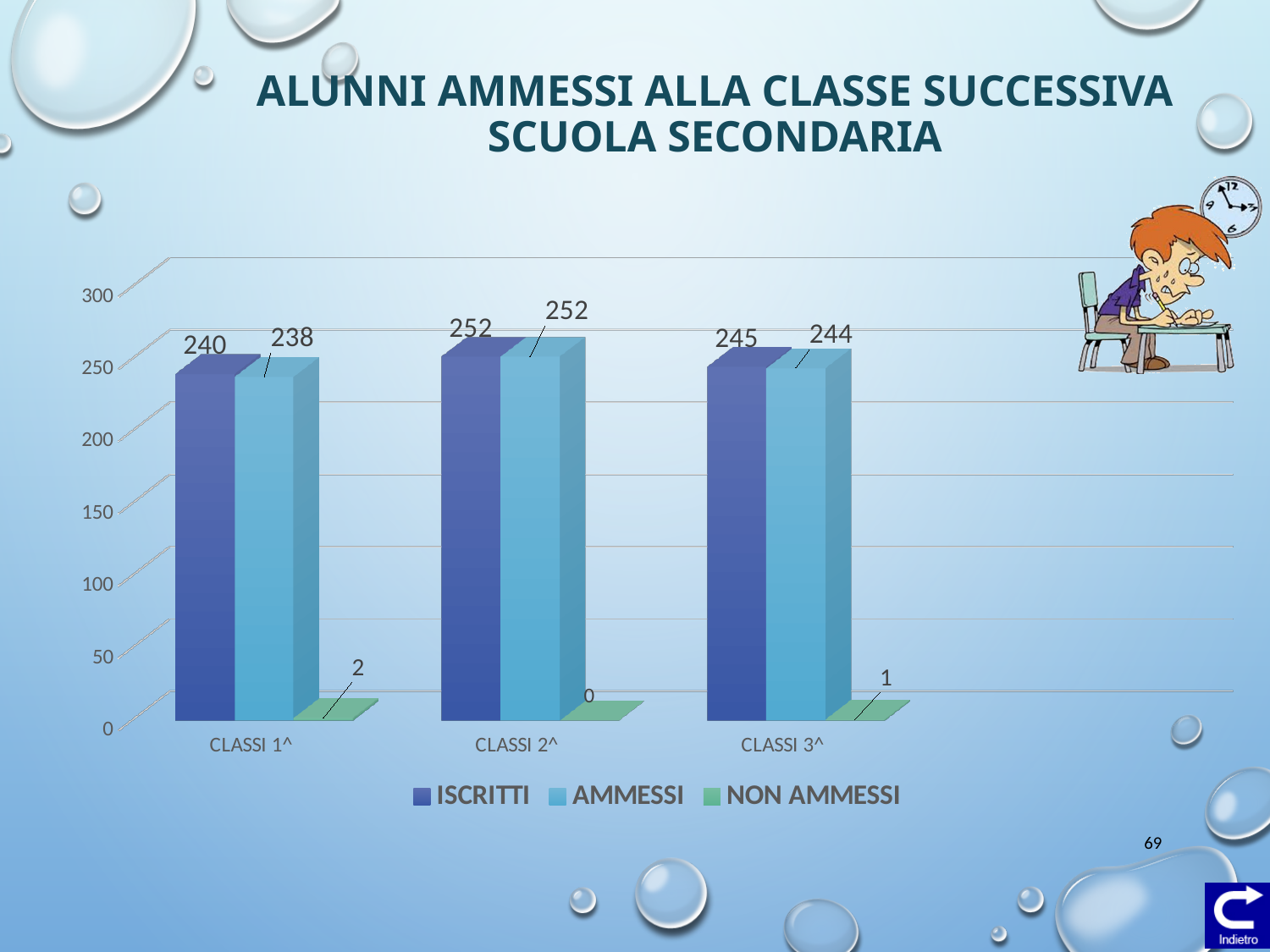
What is the NON AMMESSI value for CLASSI 3^? 1 How many classes are shown on the x axis? 3 What is the difference between the ISCRITTI values for CLASSI 2^ and CLASSI 3^? 7 Which is larger, the AMMESSI value for CLASSI 3^ or the AMMESSI value for CLASSI 1^? CLASSI 3^ What is the difference between ISCRITTI and AMMESSI for CLASSI 1^? 2 What kind of chart is shown on the slide? bar chart What is the title of the chart? ALUNNI AMMESSI ALLA CLASSE SUCCESSIVA SCUOLA SECONDARIA Which class has the lowest AMMESSI value? CLASSI 1^ How many series does the legend list? 3 What is the ISCRITTI value for CLASSI 1^? 240 Which class has the highest ISCRITTI value? CLASSI 2^ What is the AMMESSI value for CLASSI 2^? 252